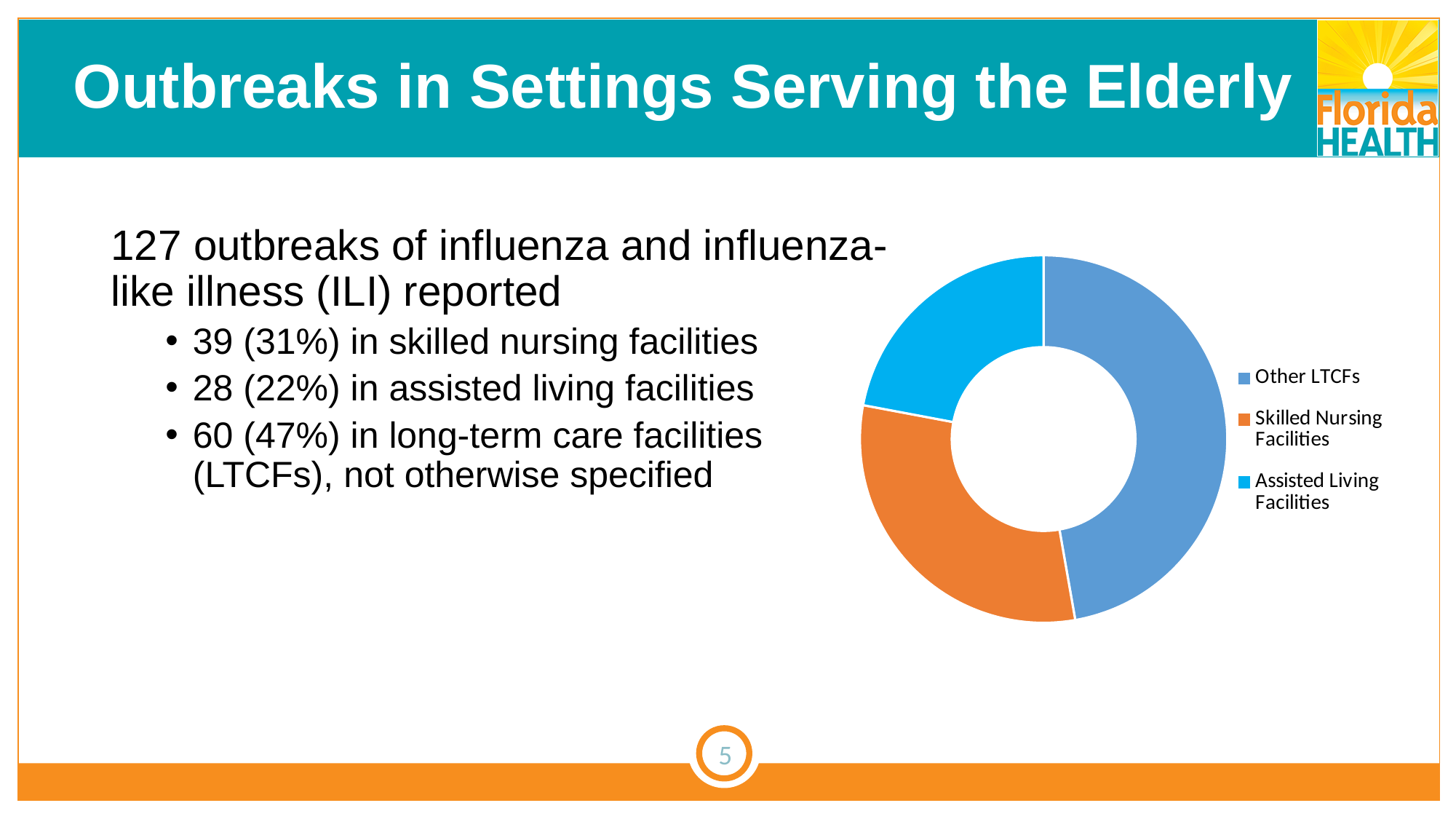
What is the difference in outbreaks between the Other LTCFs slice (60) and the Skilled Nursing Facilities slice (39)? 21 How many entries does the chart legend list? 3 According to the slide, what share of outbreaks does the Other LTCFs slice represent? 47% Which category has the largest slice in the donut chart? Other LTCFs Which category has the smallest slice in the donut chart? Assisted Living Facilities According to the slide, how many outbreaks does the Assisted Living Facilities slice represent? 28 Which slice is larger, Skilled Nursing Facilities or Assisted Living Facilities? Skilled Nursing Facilities According to the slide, what share of outbreaks does the Skilled Nursing Facilities slice represent? 31% What colour is the Skilled Nursing Facilities slice in the donut chart? Orange What kind of chart is shown on the slide? Pie chart (donut) How many slices does the donut chart have? 3 Which slice is larger, Other LTCFs or Skilled Nursing Facilities? Other LTCFs